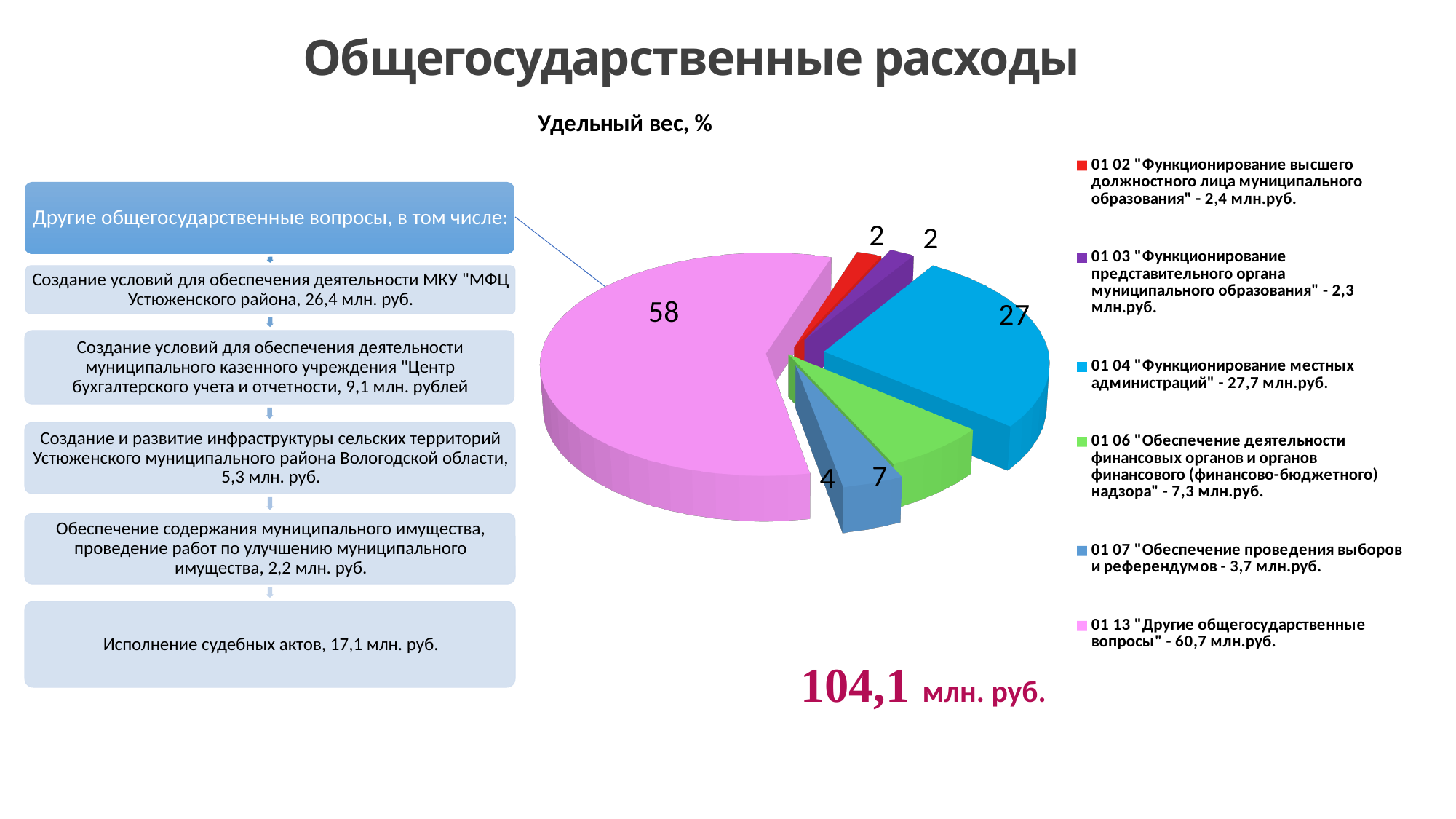
What colour is the largest slice of the pie chart? Pink What is the value shown for the slice 01 07 "Обеспечение проведения выборов и референдумов"? 4 What is the value shown for the slice 01 06 "Обеспечение деятельности финансовых органов..."? 7 Which slice is larger: 01 04 "Функционирование местных администраций" or 01 06 "Обеспечение деятельности финансовых органов..."? 01 04 "Функционирование местных администраций" What is the value shown for the slice 01 13 "Другие общегосударственные вопросы"? 58 What is the difference between the values for 01 13 "Другие общегосударственные вопросы" and 01 04 "Функционирование местных администраций"? 31 What is the title of the pie chart? Удельный вес, % How many slices does the pie chart have? 6 How many entries does the chart legend list? 6 Which category has the largest slice in the pie chart? 01 13 "Другие общегосударственные вопросы" What kind of chart is shown on the slide? Pie chart What is the value shown for the slice 01 04 "Функционирование местных администраций"? 27